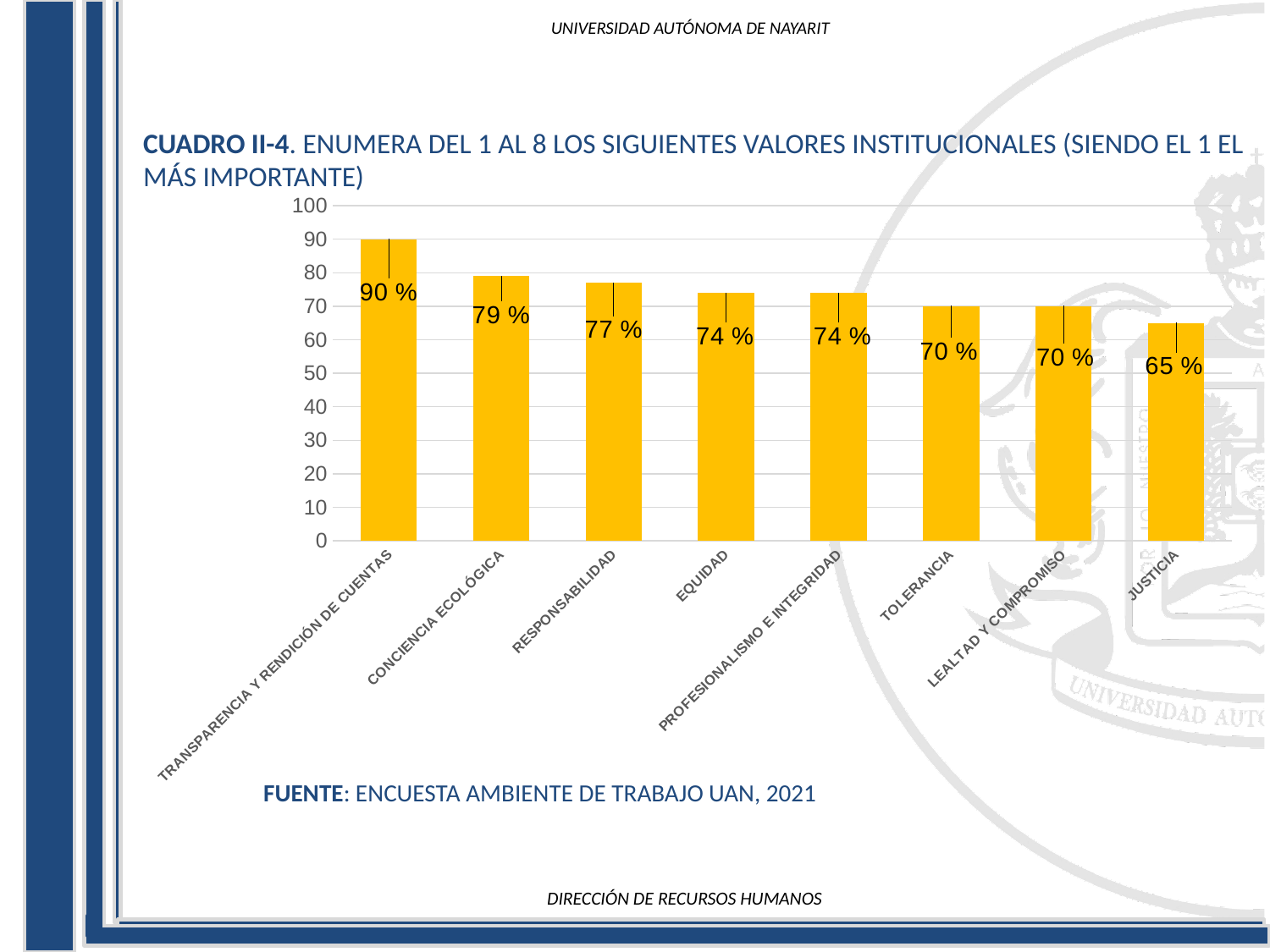
Which is larger, the value for CONCIENCIA ECOLÓGICA or the value for TOLERANCIA? CONCIENCIA ECOLÓGICA What is the value for TRANSPARENCIA Y RENDICIÓN DE CUENTAS? 90 % Which category has the highest value? TRANSPARENCIA Y RENDICIÓN DE CUENTAS How many categories are shown in the chart? 8 Which category has the lowest value? JUSTICIA What is the value for RESPONSABILIDAD? 77 % What kind of chart is shown on the slide? Bar chart What is the difference between the values for TRANSPARENCIA Y RENDICIÓN DE CUENTAS and JUSTICIA? 25 % What is the value for JUSTICIA? 65 % What is the value for CONCIENCIA ECOLÓGICA? 79 % Do the values rise or fall from left to right along the x axis? Fall What source is cited below the chart? ENCUESTA AMBIENTE DE TRABAJO UAN, 2021